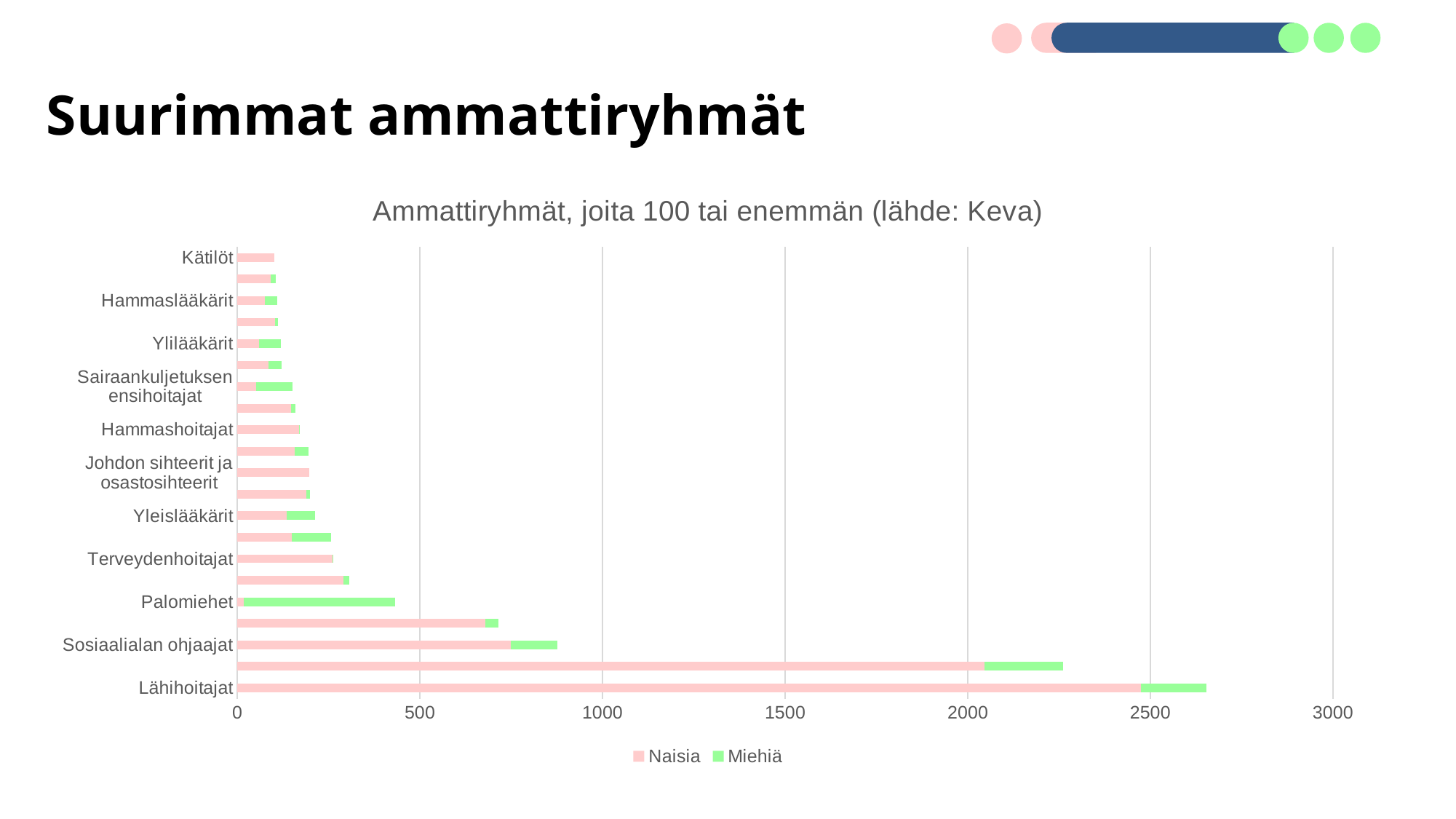
For Palomiehet, which series makes up the larger part of the bar, Naisia or Miehiä? Miehiä Is the total value for Palomiehet greater or less than 500? less Which has the larger total bar, Palomiehet or Terveydenhoitajat? Palomiehet Is the total value for Sosiaalialan ohjaajat greater or less than 1000? less Is the total value for Terveydenhoitajat greater or less than 500? less How many series does the legend list? 2 What are the two series named in the legend? Naisia and Miehiä What kind of chart is shown on the slide? bar chart Which occupational group has the longest bar in total? Lähihoitajat Which has the larger total bar, Lähihoitajat or Sosiaalialan ohjaajat? Lähihoitajat What is the title of the chart? Ammattiryhmät, joita 100 tai enemmän (lähde: Keva)